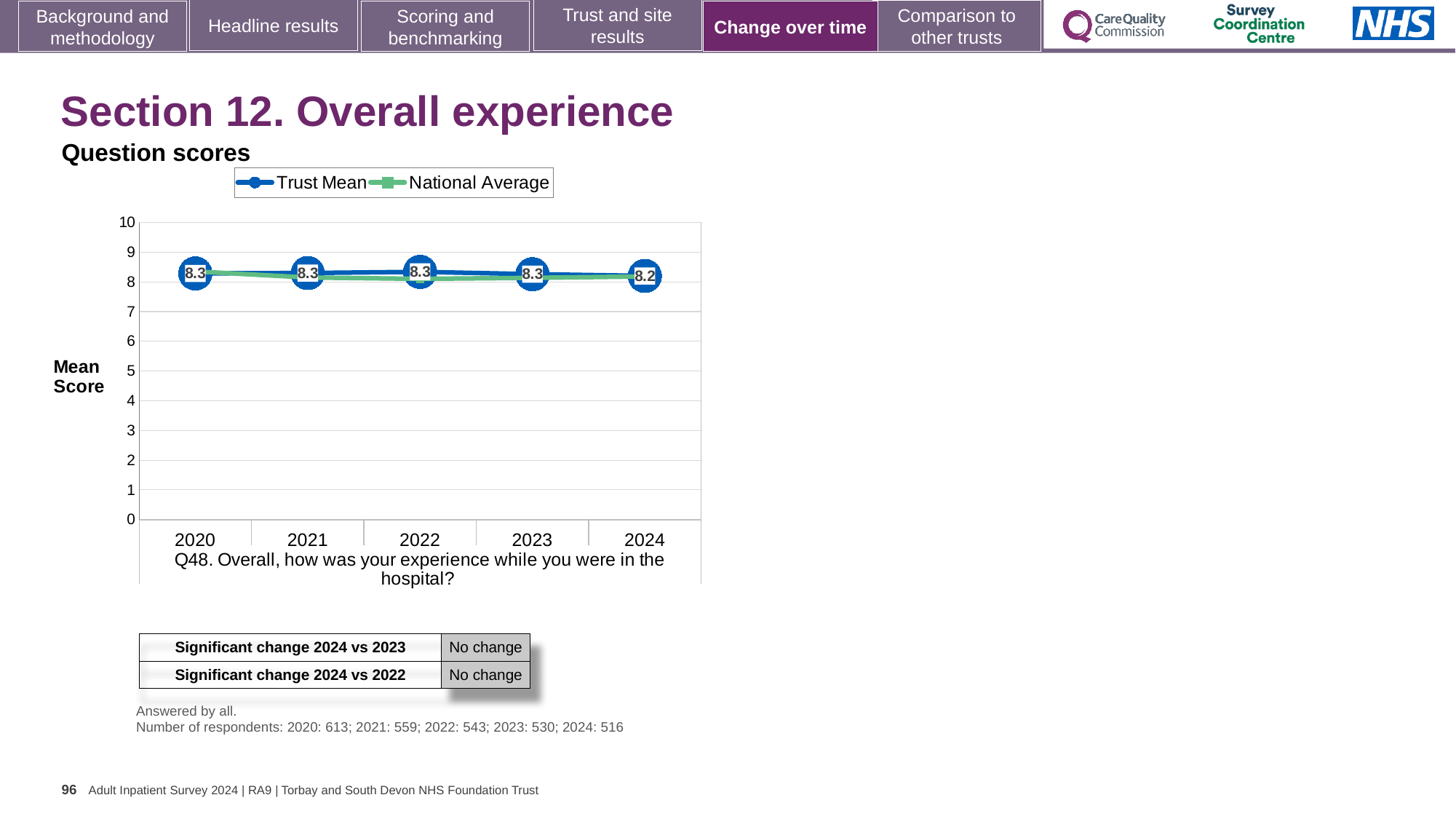
What is the Trust Mean score for 2020? 8.3 What is the Trust Mean score for 2022? 8.3 Which year has the lowest Trust Mean score? 2024 Does the Trust Mean score rise or fall from 2020 to 2024? Fall What is the Trust Mean score for 2024? 8.2 Which is larger, the Trust Mean score for 2023 or for 2024? 2023 How many series does the legend list? 2 What is the difference between the Trust Mean score in 2020 and in 2024? 0.1 How many years are plotted on the x axis? 5 Is the National Average value for 2020 greater or less than 9? less Is the National Average value for 2024 greater or less than 7? greater What kind of chart is shown? Line chart